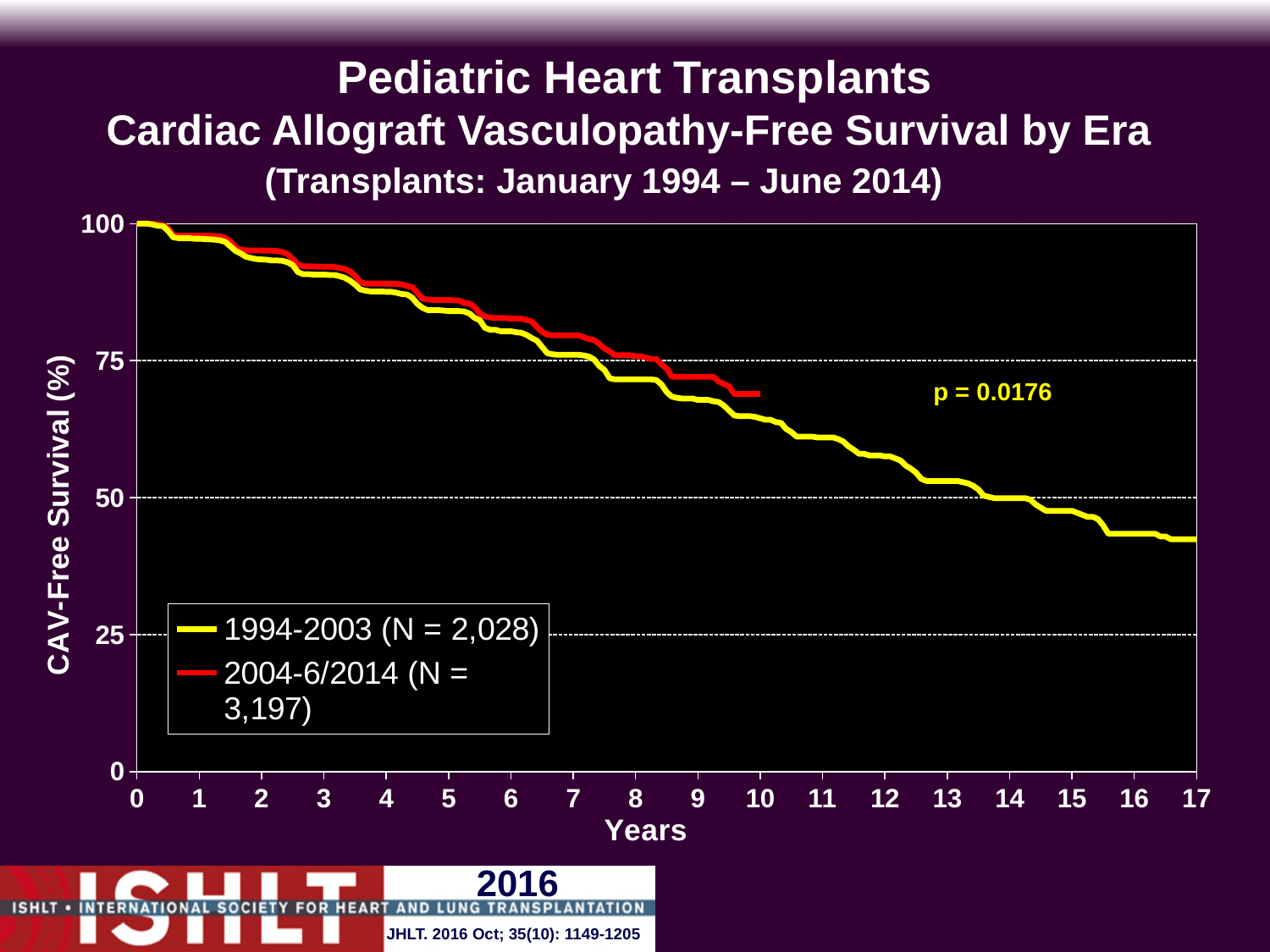
At 8 years, which era has the higher CAV-free survival, 1994-2003 or 2004-6/2014? 2004-6/2014 Is the CAV-free survival for the 1994-2003 era at 17 years greater or less than 50%? less What is the p-value shown on the chart? p = 0.0176 Is the CAV-free survival for the 1994-2003 era at 10 years greater or less than 50%? greater Is the CAV-free survival for the 2004-6/2014 era at 5 years greater or less than 75%? greater What is the CAV-free survival at year 0 for both eras? 100 What kind of chart is shown on the slide? line chart Do the CAV-free survival curves rise or fall as years increase? fall What is the maximum value shown on the x axis (Years)? 17 How many series does the legend list? 2 What is the number of patients (N) in the 1994-2003 era according to the legend? 2,028